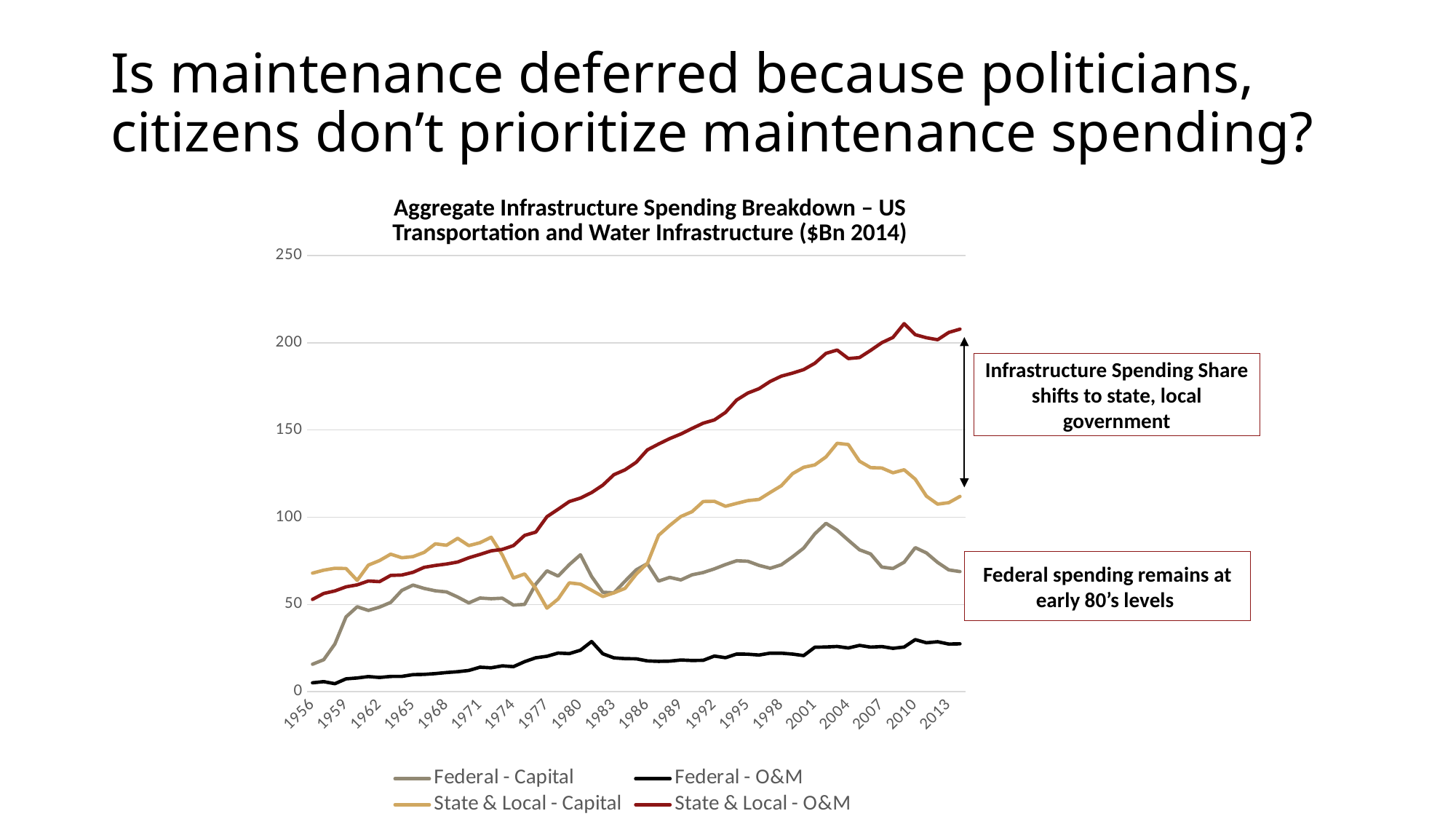
Is the value for State & Local - Capital in 2004 greater or less than 100? greater Which series has the highest value in 2013? State & Local - O&M Which series has the lowest value in 2013? Federal - O&M Does the State & Local - O&M series generally rise or fall from 1956 to 2013? Rise What colour is the line for State & Local - O&M? Dark red Is the value for Federal - O&M in 2013 greater or less than 50? less Is the value for State & Local - O&M in 2013 greater or less than 200? greater What kind of chart is shown on the slide? Line chart In 2013, which is larger: State & Local - Capital or Federal - Capital? State & Local - Capital How many series does the chart's legend list? 4 What is the title of the chart? Aggregate Infrastructure Spending Breakdown – US Transportation and Water Infrastructure ($Bn 2014)